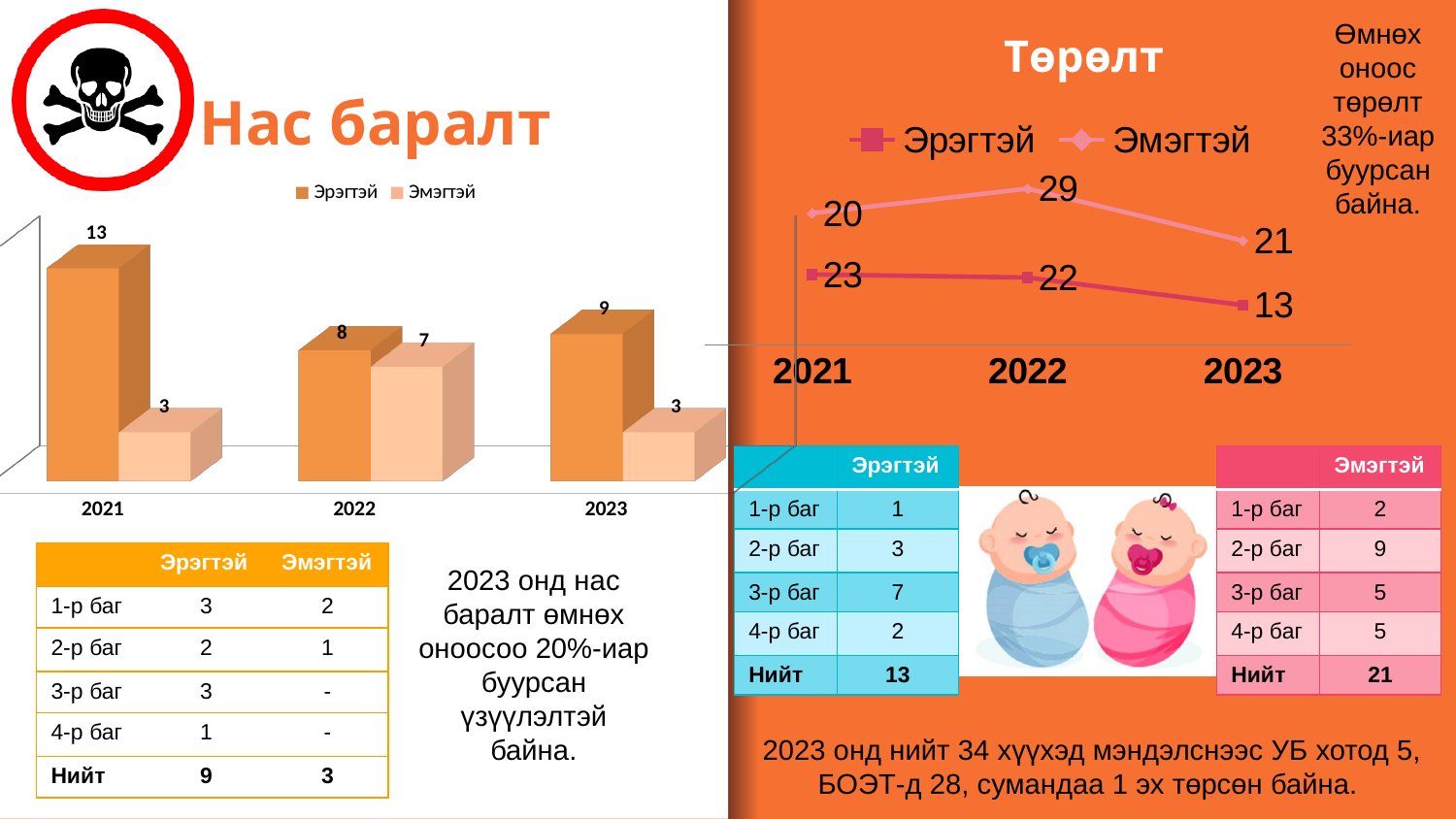
In the 'Нас баралт' chart, what is the value for Эмэгтэй in 2022? 7 In the 'Төрөлт' chart, what is the Эмэгтэй value for 2022? 29 In the 'Төрөлт' chart, what is the Эрэгтэй value for 2023? 13 In the 'Нас баралт' chart, what is the difference between the Эрэгтэй and Эмэгтэй values in 2023? 6 In the 'Нас баралт' chart, how many years are shown on the x axis? 3 In the 'Нас баралт' chart, what is the value for Эрэгтэй in 2021? 13 In the 'Төрөлт' chart, which year has the lowest Эрэгтэй value? 2023 In the 'Төрөлт' chart, does the Эрэгтэй series rise or fall from 2021 to 2023? Fall In the 'Төрөлт' chart, which is larger in 2021, Эрэгтэй or Эмэгтэй? Эрэгтэй In the 'Нас баралт' chart, which year has the highest Эрэгтэй value? 2021 In the 'Төрөлт' chart, how many series does the legend list? 2 In the 'Нас баралт' chart, what kind of chart is shown? Bar chart